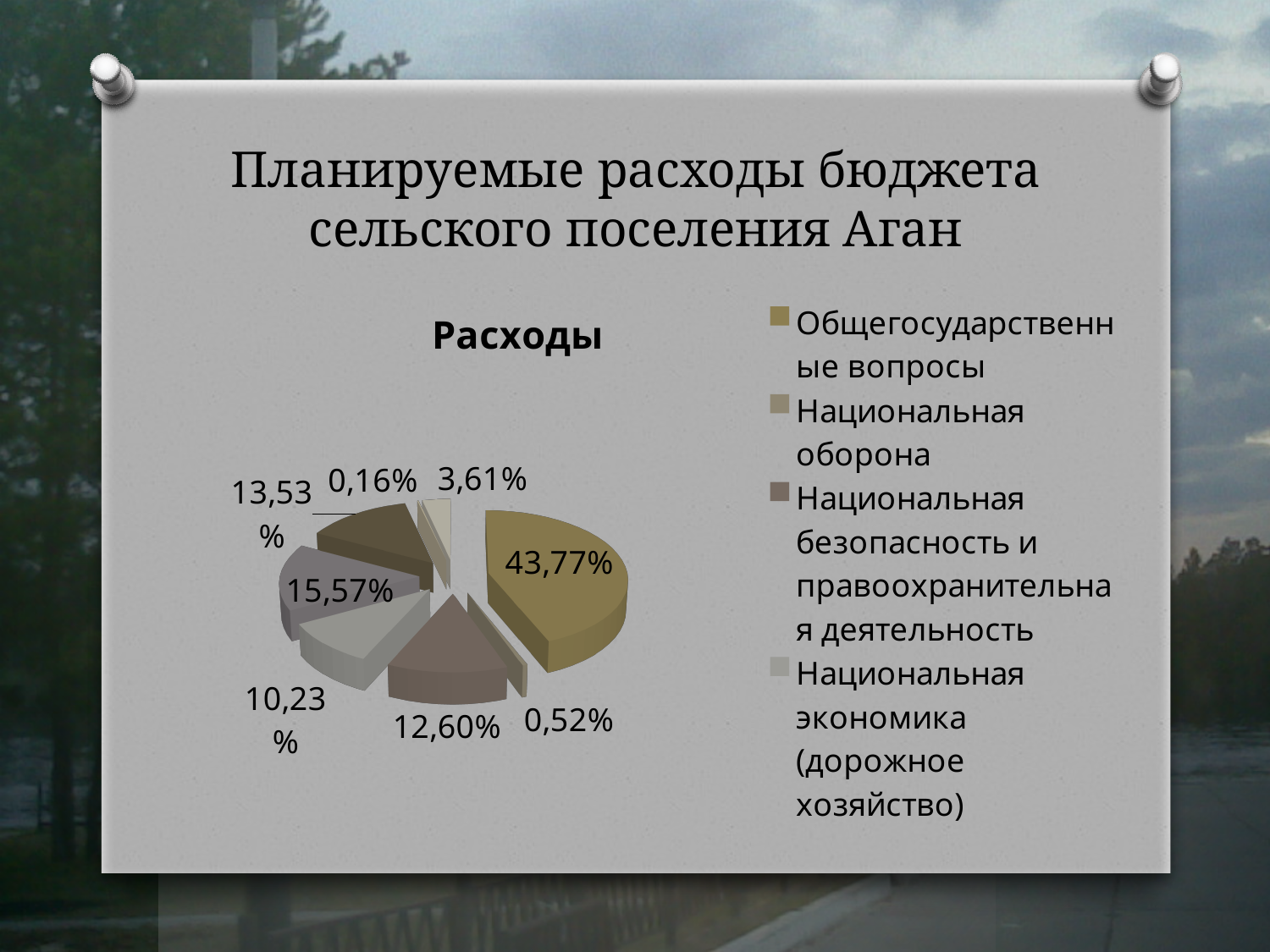
What share of the pie does Общегосударственные вопросы have? 43,77% What is the title of the chart? Расходы How many slices does the pie chart have? 8 Which is larger, the 3,61% slice or the 0,52% slice? 3,61% What is the smallest slice of the pie chart? 0,16% What is the difference between the largest slice (43,77%) and the 15,57% slice? 28,20% What is the difference between the 15,57% slice and the 13,53% slice? 2,04% What share of the pie does Национальная безопасность и правоохранительная деятельность have? 12,60% What is the first entry listed in the chart legend? Общегосударственные вопросы What kind of chart is shown on the slide? pie chart What is the largest slice of the pie chart? 43,77% Which is larger, the 12,60% slice or the 10,23% slice? 12,60%